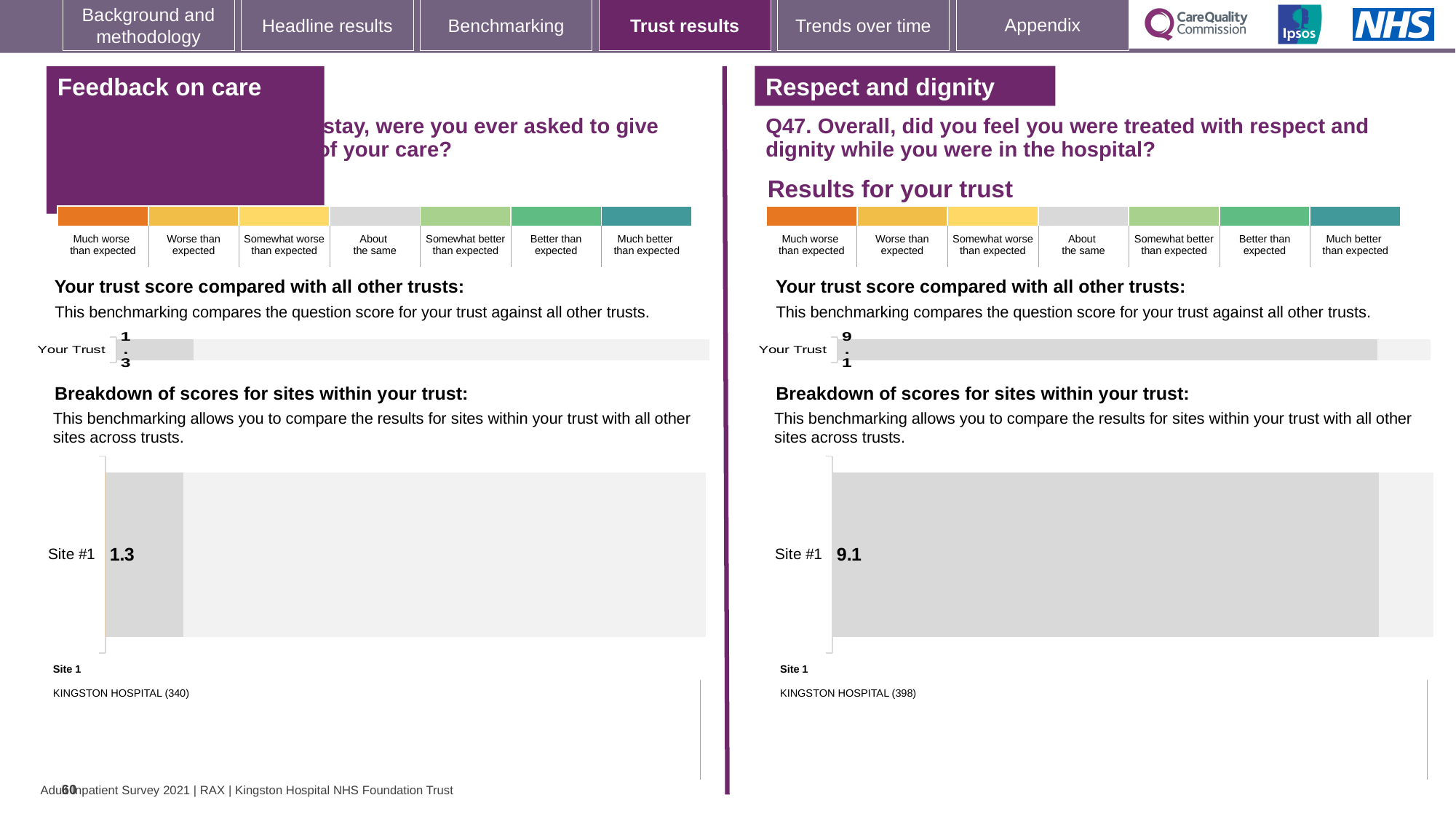
On the right-hand 'Respect and dignity' section, what is the score shown for Your Trust in the 'Your trust score compared with all other trusts' chart? 9.1 Which is larger: the Your Trust score in the 'Feedback on care' section or the Your Trust score in the 'Respect and dignity' section? Respect and dignity On the left-hand 'Feedback on care' section, what is the score shown for Your Trust in the 'Your trust score compared with all other trusts' chart? 1.3 In the 'Breakdown of scores for sites within your trust' chart on the right-hand 'Respect and dignity' section, what is the value for Site #1? 9.1 What is the difference between the Site #1 score in the 'Respect and dignity' section and the Site #1 score in the 'Feedback on care' section? 7.8 How many sites are shown in the 'Breakdown of scores for sites within your trust' chart on the right-hand 'Respect and dignity' section? 1 In the 'Breakdown of scores for sites within your trust' chart on the left-hand section, which hospital is listed as Site 1? KINGSTON HOSPITAL (340) In the 'Breakdown of scores for sites within your trust' chart on the right-hand section, which hospital is listed as Site 1? KINGSTON HOSPITAL (398) Is the Your Trust score in the 'Feedback on care' section equal to the Site #1 score in the same section? Yes In the 'Breakdown of scores for sites within your trust' chart on the left-hand 'Feedback on care' section, what is the value for Site #1? 1.3 What is the difference between the Your Trust score in the 'Respect and dignity' section and the Your Trust score in the 'Feedback on care' section? 7.8 What type of chart is used to show the Site #1 score in the 'Breakdown of scores for sites within your trust' section on the left? Bar chart